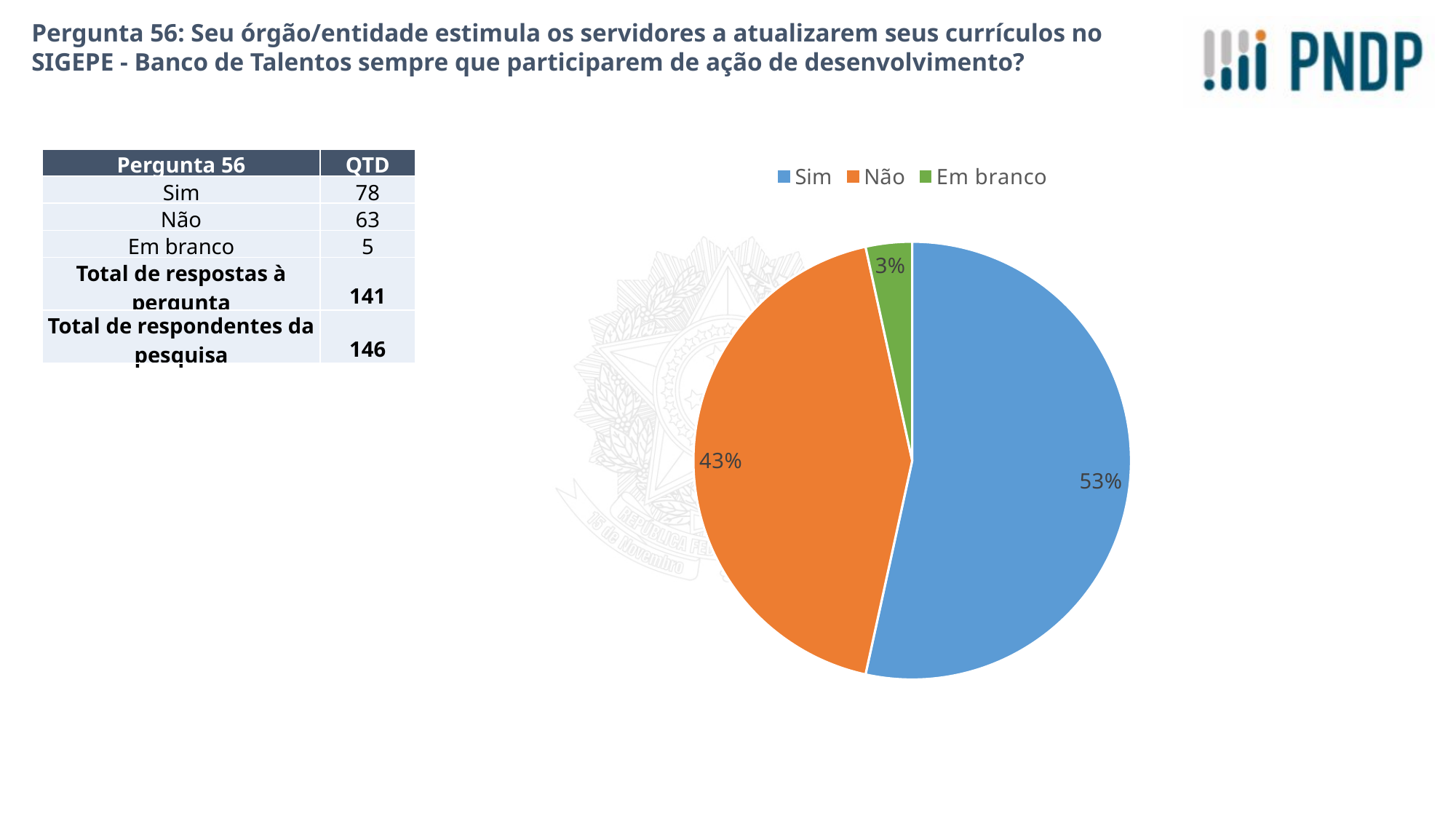
How many entries does the legend list? 3 What share of the pie does the "Não" slice represent? 43% Which category has the smallest slice of the pie? Em branco What kind of chart is shown on the slide? pie chart Which slice is larger, "Não" or "Em branco"? Não Where is the legend positioned relative to the pie chart? above the chart Which category has the largest slice of the pie? Sim What share of the pie does the "Sim" slice represent? 53% What colour is the "Não" slice in the pie chart? orange What share of the pie does the "Em branco" slice represent? 3% How many slices does the pie chart have? 3 What is the difference in percentage points between the "Sim" and "Não" slices? 10 percentage points